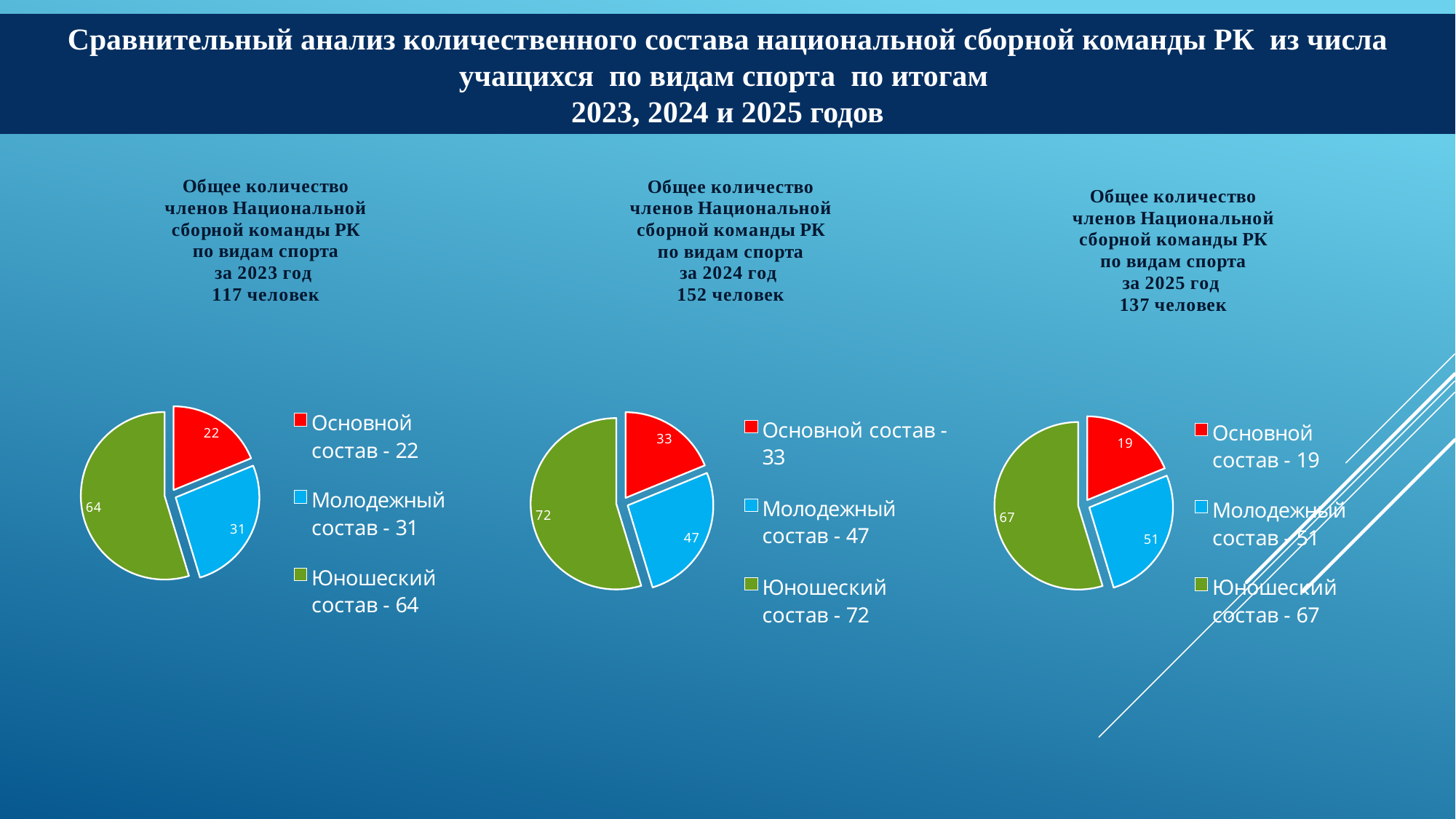
In the 2023 pie chart, how many members are in the Основной состав? 22 In the 2024 pie chart, what colour is the slice for Юношеский состав? Green In the 2024 pie chart, what is the value for Молодежный состав? 47 In the 2023 pie chart, which is larger: Молодежный состав or Основной состав? Молодежный состав In the 2025 pie chart, what is the difference between Молодежный состав and Основной состав? 32 In the 2023 pie chart, which category has the largest slice? Юношеский состав In the 2025 pie chart, which category has the smallest slice? Основной состав How many slices does the 2024 pie chart have? 3 What type of chart is used for the 2023 data? Pie chart In the 2025 pie chart, what is the value for Юношеский состав? 67 How many entries does the legend of the 2025 chart list? 3 In the 2024 pie chart, what is the difference between Юношеский состав and Основной состав? 39